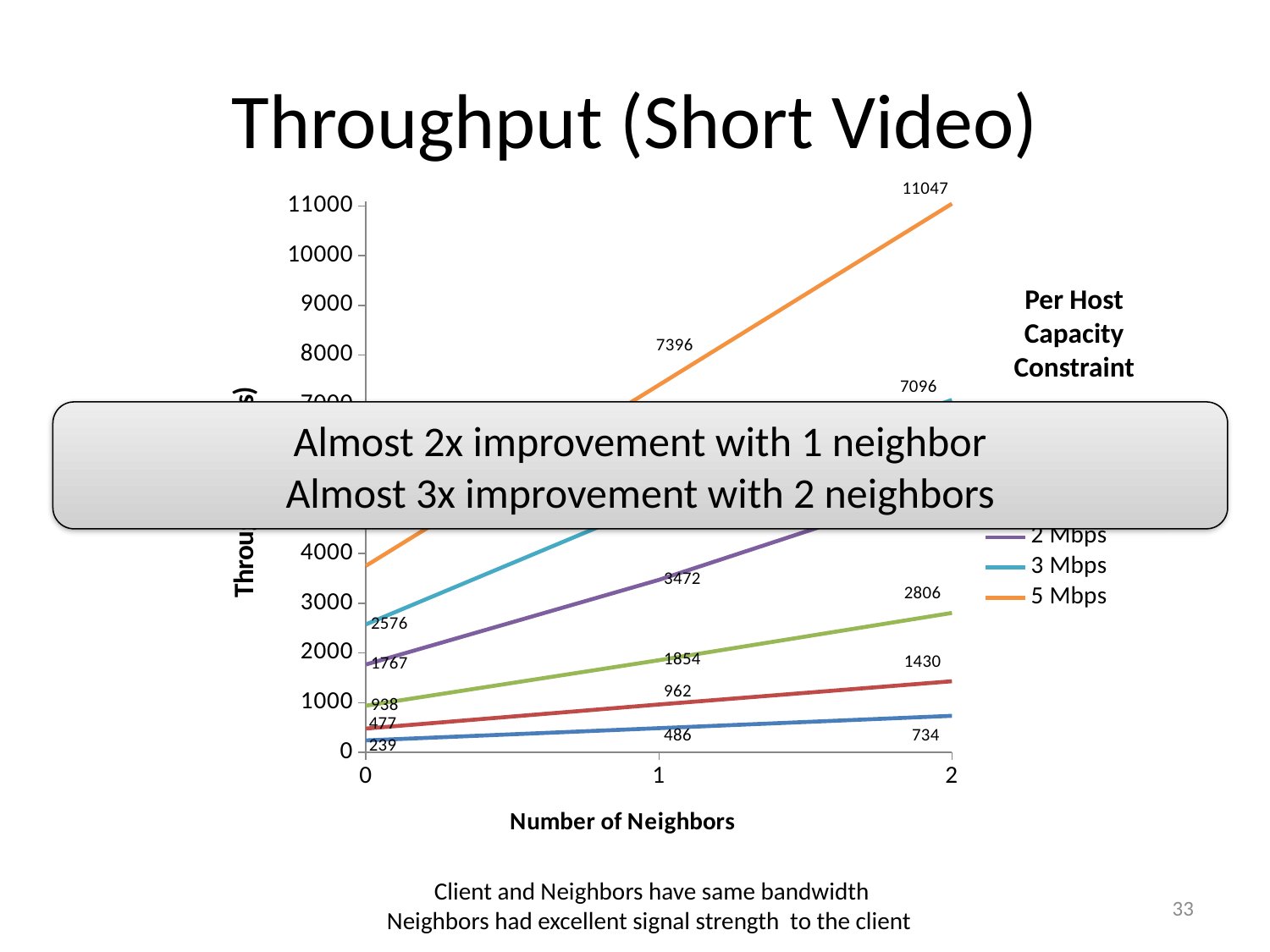
Is the 5 Mbps throughput with 0 neighbors greater or less than 5000? less What is the throughput for the 3 Mbps series with 0 neighbors? 2576 What is the throughput for the 5 Mbps series with 1 neighbor? 7396 What is the throughput for the 3 Mbps series with 2 neighbors? 7096 What kind of chart is shown on the slide? line chart What is the throughput for the 2 Mbps series with 0 neighbors? 1767 How much higher is the 5 Mbps throughput with 2 neighbors than with 1 neighbor? 3651 What is the throughput for the 2 Mbps series with 1 neighbor? 3472 With 2 neighbors, which series has the higher throughput, 5 Mbps or 3 Mbps? 5 Mbps Does the 5 Mbps throughput rise or fall as the number of neighbors increases? rises What is the throughput for the 5 Mbps series with 2 neighbors? 11047 What is the difference in 3 Mbps throughput between 2 neighbors and 0 neighbors? 4520